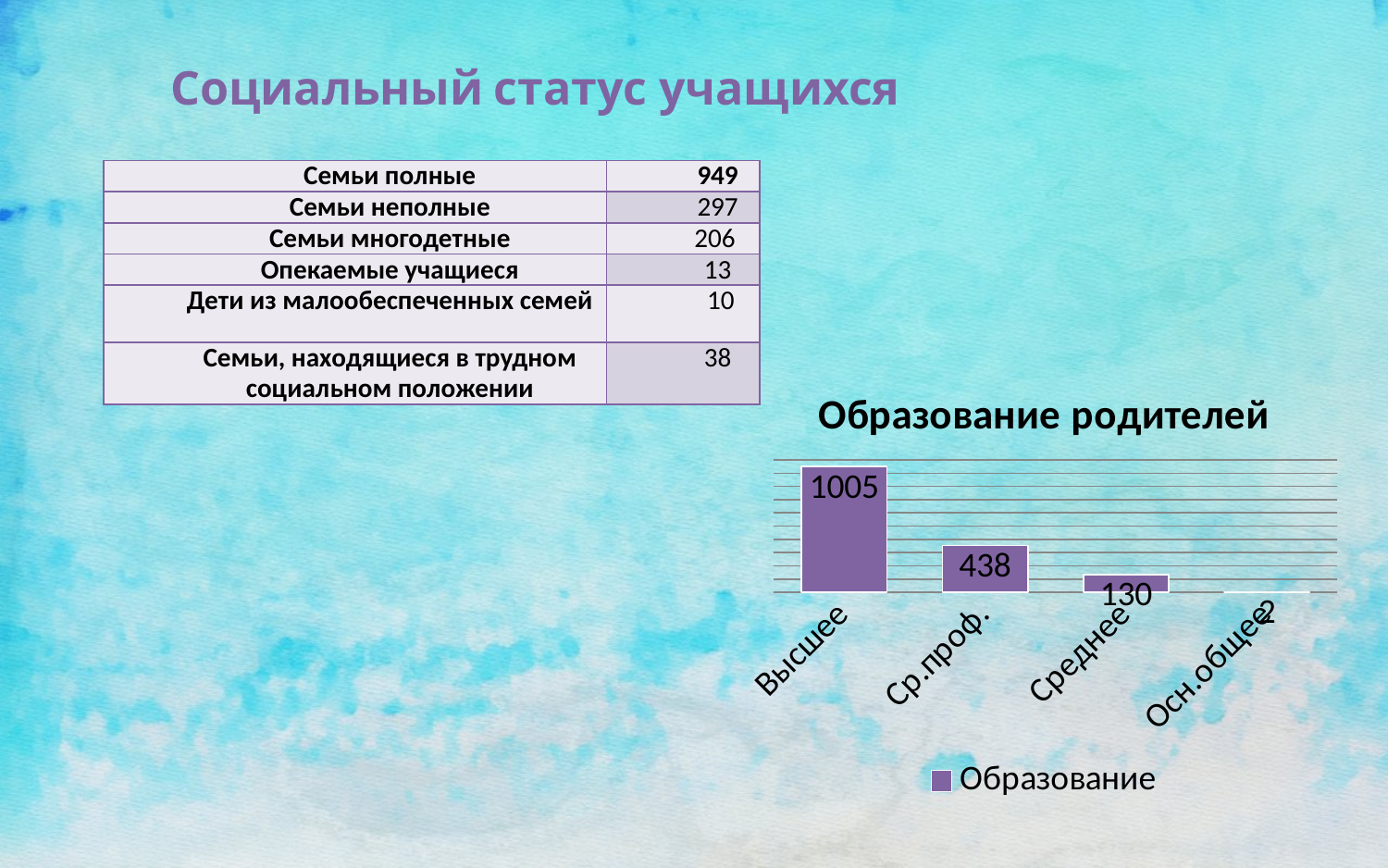
In the 'Образование родителей' chart, which category has the lowest value? Осн.общее What type of chart is shown under the title 'Образование родителей'? bar chart In the 'Образование родителей' chart, what is the value for 'Ср.проф.'? 438 Do the values in the 'Образование родителей' chart rise or fall from left to right along the x axis? fall In the 'Образование родителей' chart, what is the difference between the values for 'Высшее' and 'Ср.проф.'? 567 How many categories are shown in the 'Образование родителей' chart? 4 In the 'Образование родителей' chart, what is the difference between the values for 'Ср.проф.' and 'Среднее'? 308 In the 'Образование родителей' chart, what is the value for 'Среднее'? 130 In the 'Образование родителей' chart, which category has the highest value? Высшее In the 'Образование родителей' chart, which is larger: the value for 'Ср.проф.' or the value for 'Среднее'? Ср.проф. In the 'Образование родителей' chart, what is the value for 'Высшее'? 1005 How many series does the legend of the 'Образование родителей' chart list? 1